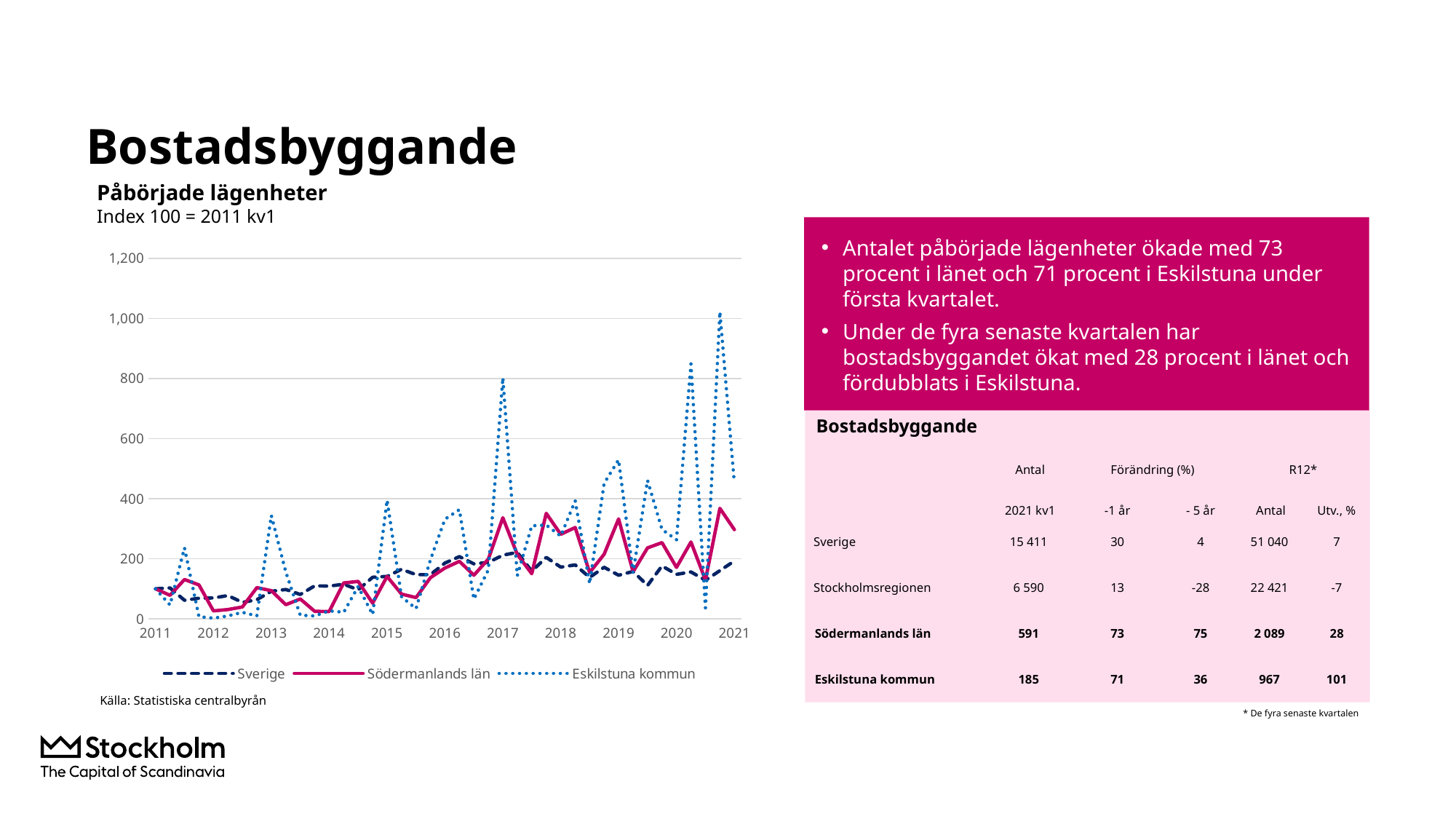
How many series does the chart legend list? 3 What is the title of the chart? Påbörjade lägenheter Which series reaches the highest peak in the chart? Eskilstuna kommun What is the index base stated under the chart title? Index 100 = 2011 kv1 Is the value for Sverige at 2021 greater or less than 400? less How many year labels are shown on the x axis? 11 Is the highest peak of the Eskilstuna kommun series greater or less than 800? greater Which series has the lowest value at the start of 2012? Eskilstuna kommun Does the Sverige series generally rise or fall from 2011 to 2021? Rise What kind of chart is shown on the slide? Line chart Is the value for Södermanlands län at 2021 greater or less than 200? greater